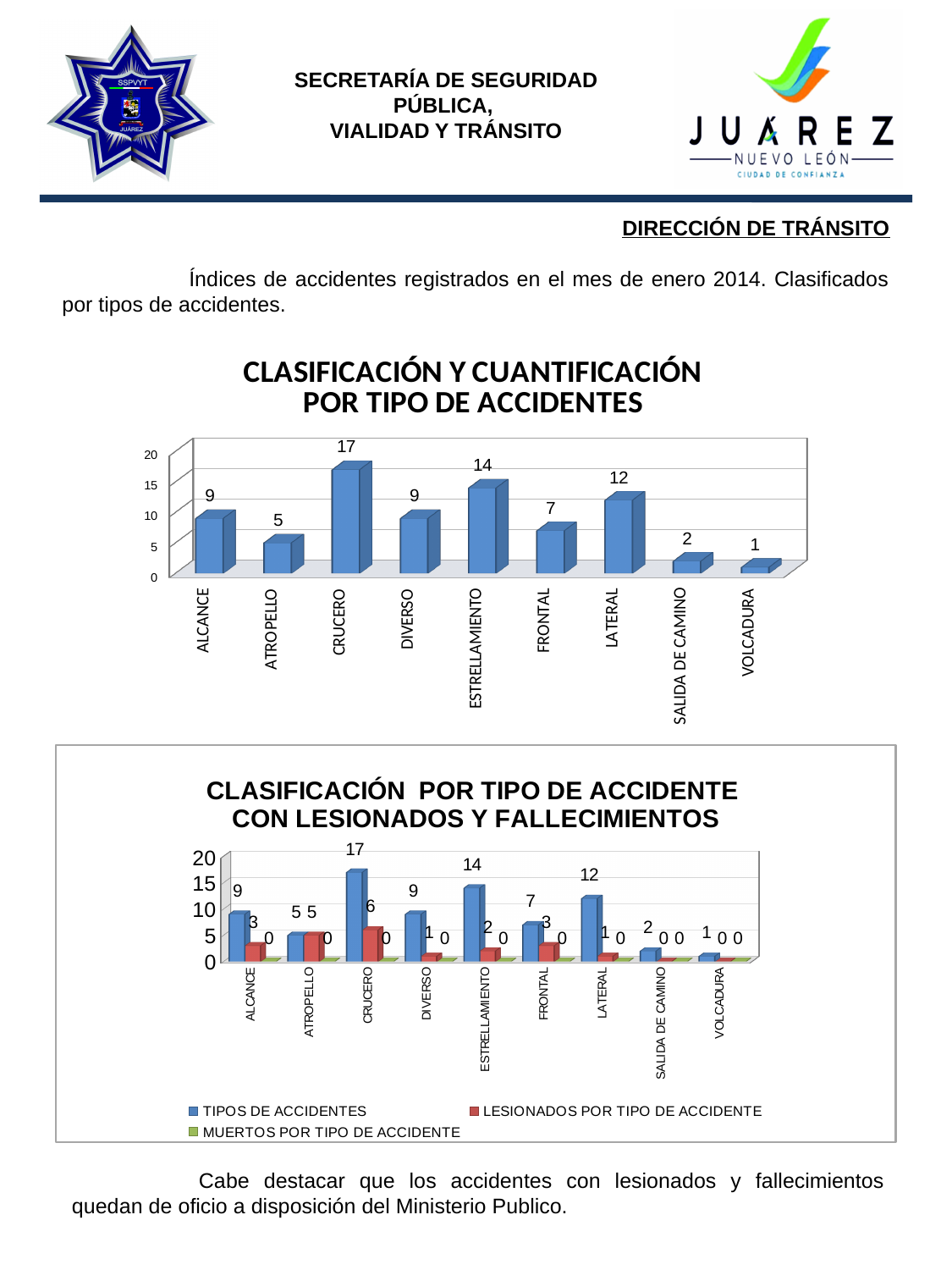
In the top chart 'CLASIFICACIÓN Y CUANTIFICACIÓN POR TIPO DE ACCIDENTES', which category has the highest value? CRUCERO In the top chart 'CLASIFICACIÓN Y CUANTIFICACIÓN POR TIPO DE ACCIDENTES', what is the value for CRUCERO? 17 In the bottom chart 'CLASIFICACIÓN POR TIPO DE ACCIDENTE CON LESIONADOS Y FALLECIMIENTOS', how many series does the legend list? 3 In the bottom chart 'CLASIFICACIÓN POR TIPO DE ACCIDENTE CON LESIONADOS Y FALLECIMIENTOS', what is the value of MUERTOS POR TIPO DE ACCIDENTE for FRONTAL? 0 In the bottom chart 'CLASIFICACIÓN POR TIPO DE ACCIDENTE CON LESIONADOS Y FALLECIMIENTOS', what is the value of LESIONADOS POR TIPO DE ACCIDENTE for ATROPELLO? 5 In the bottom chart 'CLASIFICACIÓN POR TIPO DE ACCIDENTE CON LESIONADOS Y FALLECIMIENTOS', what is the name of the third series in the legend? MUERTOS POR TIPO DE ACCIDENTE In the top chart 'CLASIFICACIÓN Y CUANTIFICACIÓN POR TIPO DE ACCIDENTES', what is the difference between ESTRELLAMIENTO and LATERAL? 2 In the bottom chart 'CLASIFICACIÓN POR TIPO DE ACCIDENTE CON LESIONADOS Y FALLECIMIENTOS', what is the value of LESIONADOS POR TIPO DE ACCIDENTE for CRUCERO? 6 In the top chart 'CLASIFICACIÓN Y CUANTIFICACIÓN POR TIPO DE ACCIDENTES', which is larger, FRONTAL or ATROPELLO? FRONTAL What kind of chart is the top chart 'CLASIFICACIÓN Y CUANTIFICACIÓN POR TIPO DE ACCIDENTES'? Bar chart In the top chart 'CLASIFICACIÓN Y CUANTIFICACIÓN POR TIPO DE ACCIDENTES', how many categories are shown on the x axis? 9 In the top chart 'CLASIFICACIÓN Y CUANTIFICACIÓN POR TIPO DE ACCIDENTES', which category has the lowest value? VOLCADURA